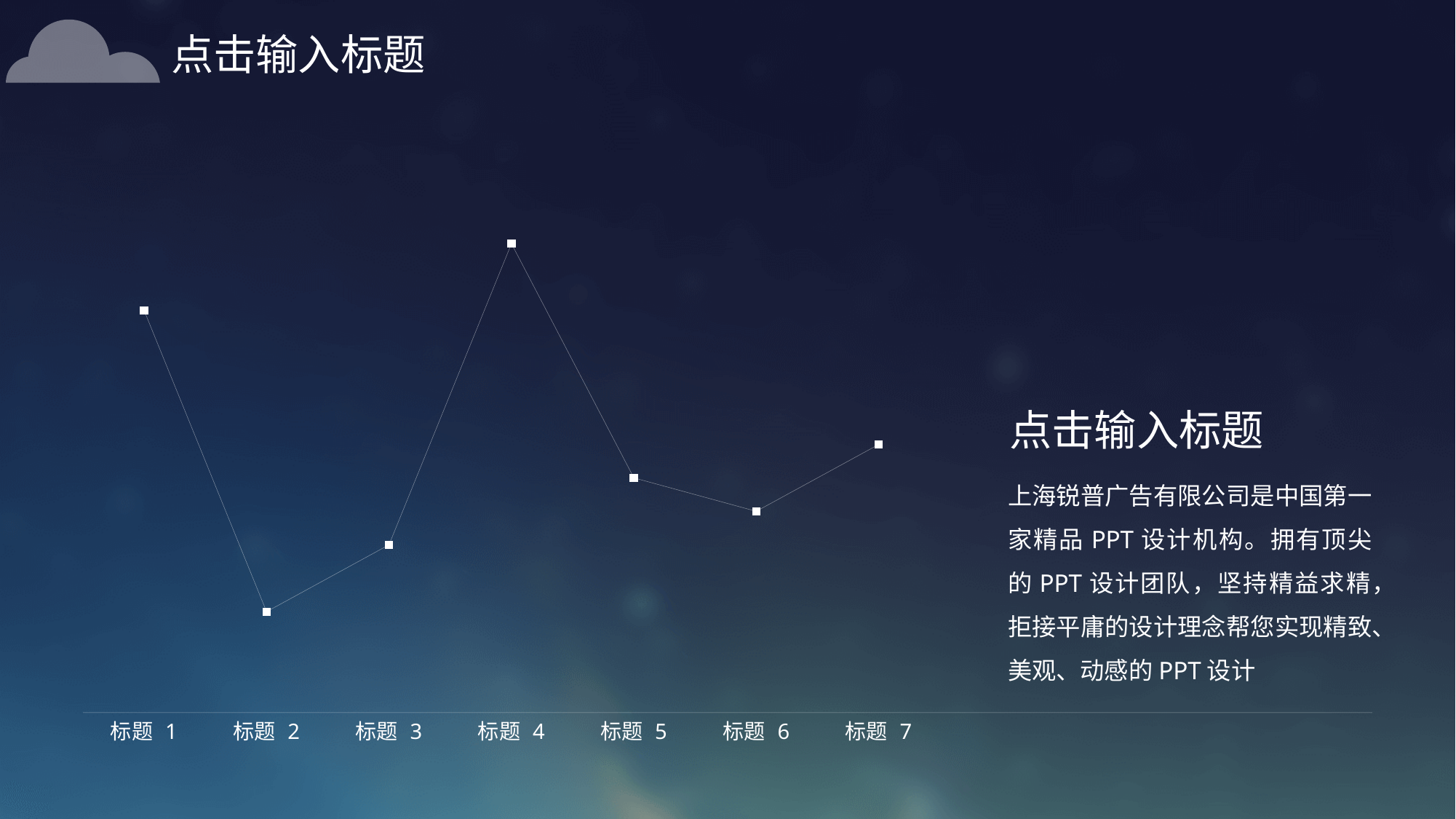
Which category has the highest value in the line chart? 标题 4 Which is larger, the value for 标题 1 or the value for 标题 2? 标题 1 How many categories are plotted along the x axis of the line chart? 7 Which is larger, the value for 标题 5 or the value for 标题 6? 标题 5 Does the line rise or fall from 标题 4 to 标题 6? fall Which is larger, the value for 标题 3 or the value for 标题 7? 标题 7 Which category has the lowest value in the line chart? 标题 2 Does the line rise or fall from 标题 1 to 标题 2? fall What is the label of the first category on the x axis of the line chart? 标题 1 What kind of chart is shown on the slide? line chart Does the line rise or fall from 标题 2 to 标题 4? rise